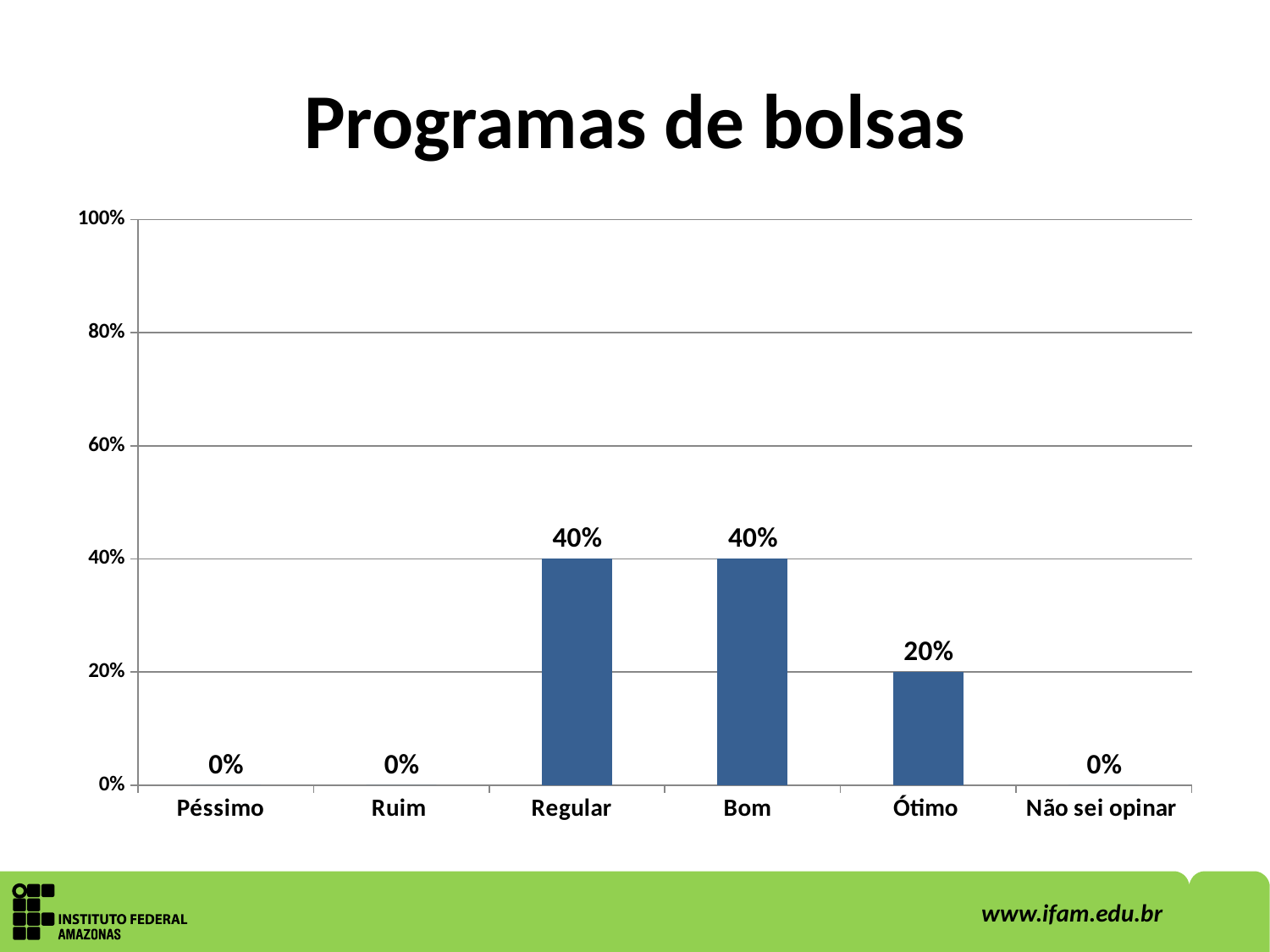
What is the difference between the values for Bom and Ótimo? 20% What kind of chart is shown on the slide? bar chart What is the value for Péssimo? 0% Which category has the lowest non-zero value? Ótimo How many categories have a value of 0%? 3 What is the title of the chart? Programas de bolsas Is the value for Bom greater or less than 60%? less What is the value for Não sei opinar? 0% What is the value for Regular? 40% What is the value for Ótimo? 20% Which is larger, the value for Regular or the value for Ótimo? Regular How many categories are shown on the x axis? 6